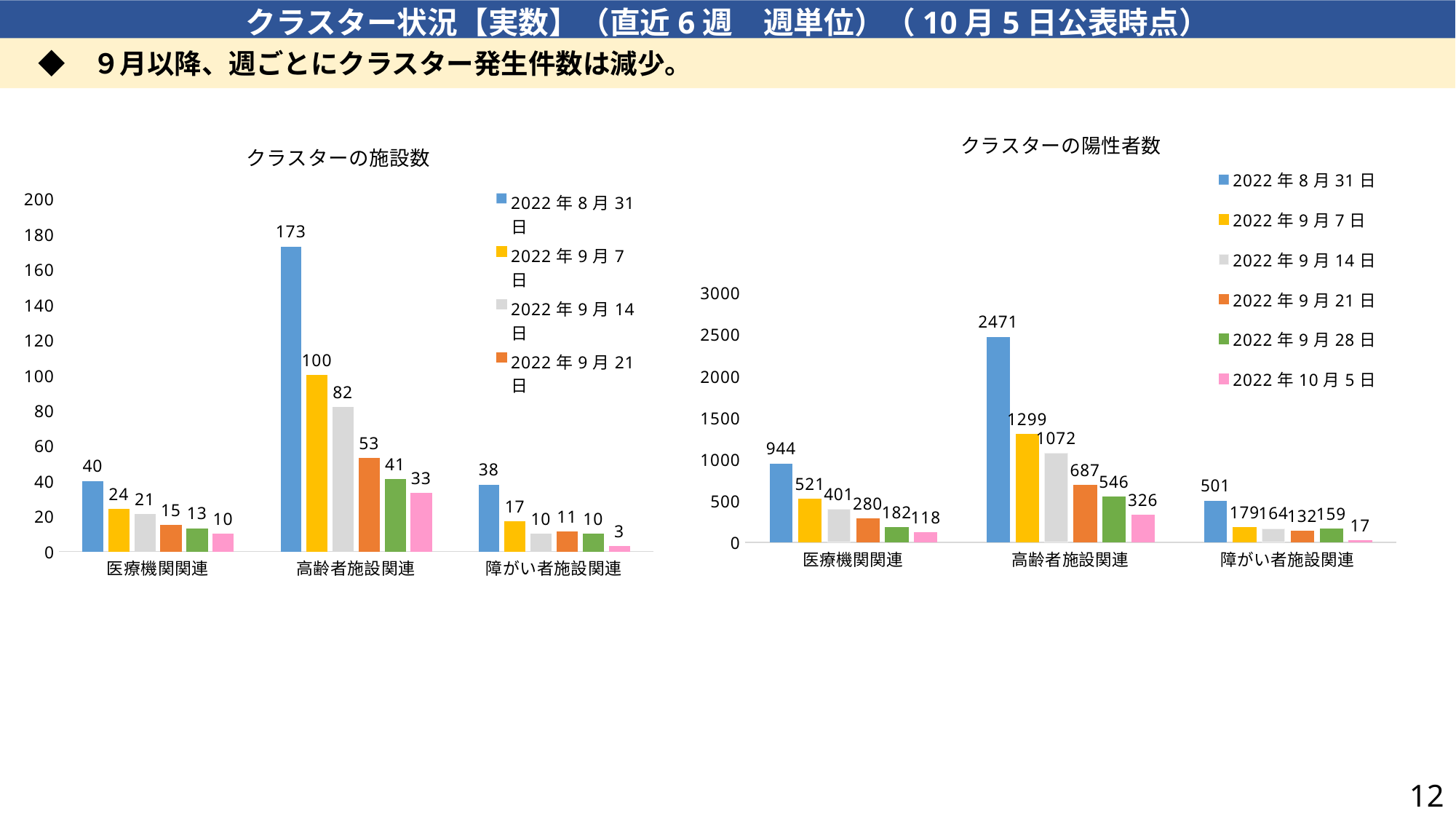
In the クラスターの陽性者数 chart, what is the value for 高齢者施設関連 on 2022年8月31日? 2471 How many series does the legend of the クラスターの陽性者数 chart list? 6 In the クラスターの陽性者数 chart, which is larger for 障がい者施設関連: the 2022年9月21日 value or the 2022年9月28日 value? 2022年9月28日 In the クラスターの施設数 chart, which category has the lowest value on 2022年9月21日? 障がい者施設関連 In the クラスターの施設数 chart, what is the difference between the 2022年8月31日 and 2022年9月7日 values for 高齢者施設関連? 73 In the クラスターの陽性者数 chart, what is the value for 障がい者施設関連 on 2022年10月5日? 17 In the クラスターの施設数 chart, do the values for 医療機関関連 rise or fall from 2022年8月31日 to 2022年10月5日? fall What kind of chart is the クラスターの施設数 chart? bar chart In the クラスターの施設数 chart, what is the value for 高齢者施設関連 on 2022年8月31日? 173 In the クラスターの陽性者数 chart, which category has the highest value on 2022年9月14日? 高齢者施設関連 In the クラスターの陽性者数 chart, what is the difference between the 2022年8月31日 and 2022年9月7日 values for 医療機関関連? 423 In the クラスターの施設数 chart, what is the value for 医療機関関連 on 2022年9月7日? 24